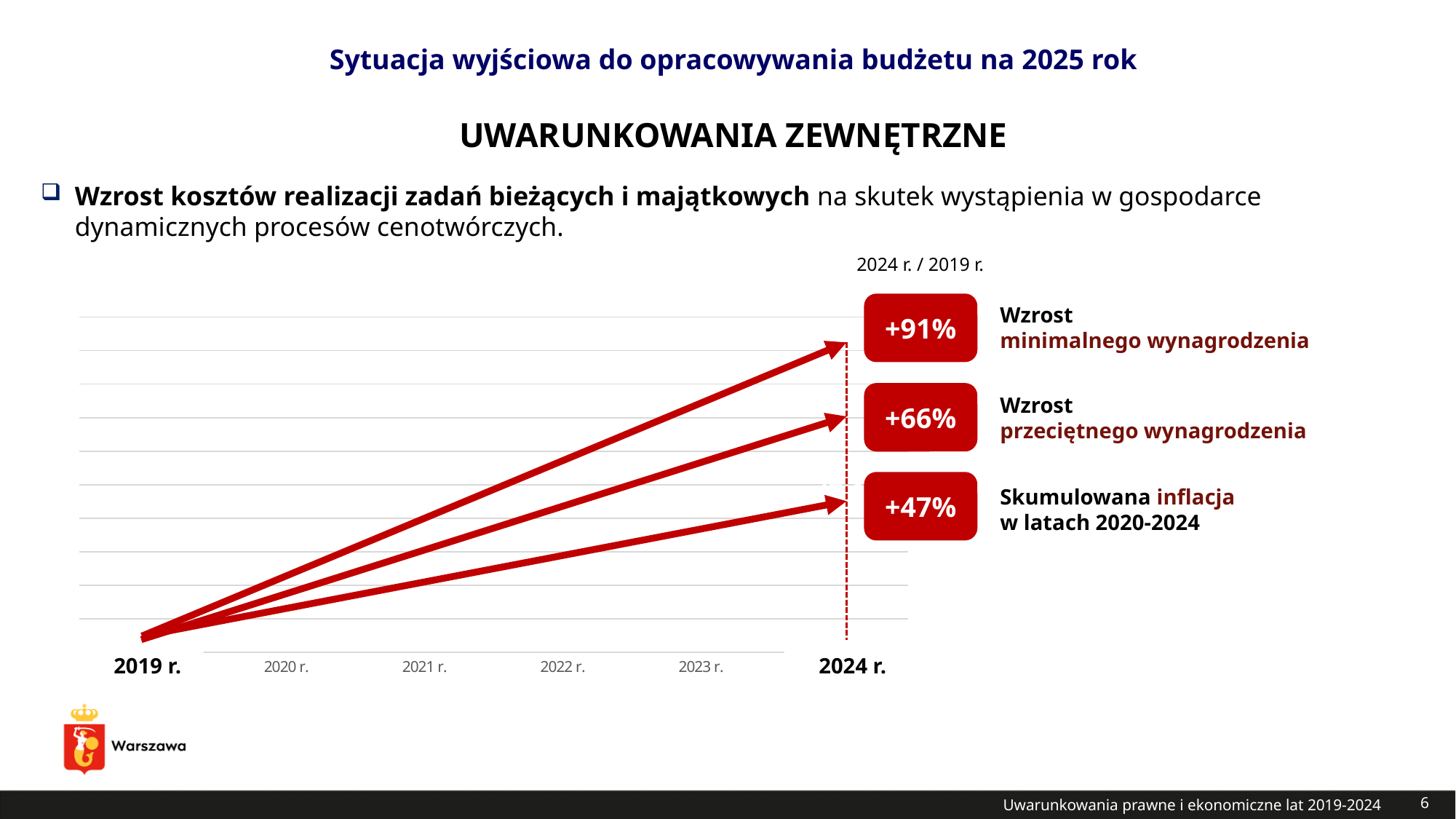
Which is larger: the growth of the average wage or the cumulative inflation in 2020-2024? Growth of the average wage What is the growth of the average wage (Wzrost przeciętnego wynagrodzenia) shown for 2024 r. / 2019 r.? +66% By how many percentage points does the minimum wage growth exceed the average wage growth? 25 percentage points What is the cumulative inflation (Skumulowana inflacja) in the years 2020-2024 shown on the chart? +47% What comparison period is written above the value boxes on the chart? 2024 r. / 2019 r. What is the growth of the minimum wage (Wzrost minimalnego wynagrodzenia) shown for 2024 r. / 2019 r.? +91% Which of the three indicators on the chart shows the lowest growth? Skumulowana inflacja w latach 2020-2024 Do the plotted lines rise or fall from 2019 r. to 2024 r.? Rise Which of the three indicators on the chart shows the highest growth? Wzrost minimalnego wynagrodzenia How many year labels are shown along the x axis of the chart? 6 By how many percentage points does the average wage growth exceed the cumulative inflation? 19 percentage points How many indicators (arrows) are plotted on the chart? 3